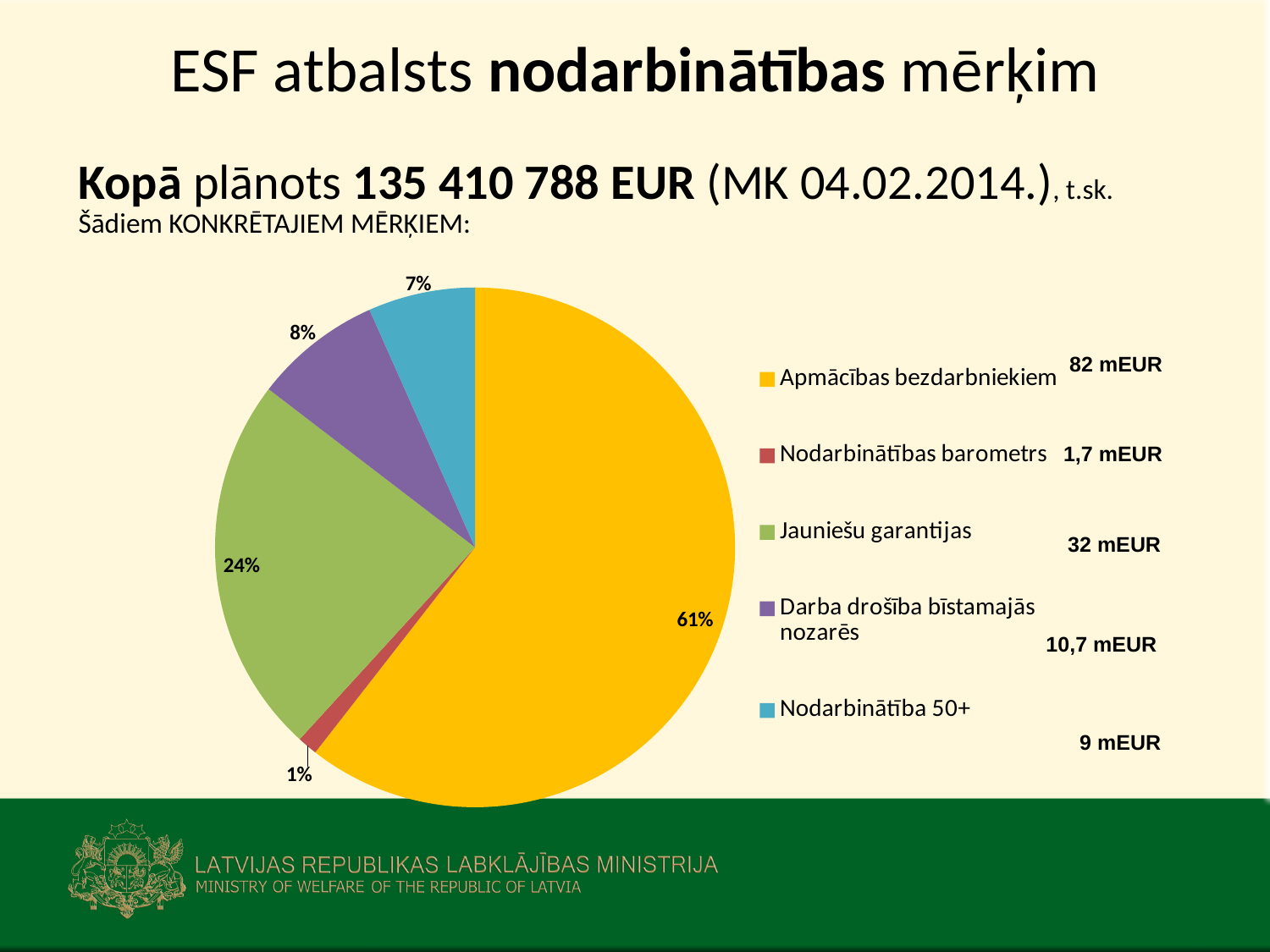
Which slice is larger, Darba drošība bīstamajās nozarēs or Nodarbinātība 50+? Darba drošība bīstamajās nozarēs How many slices does the pie chart have? 5 What share of the pie does Darba drošība bīstamajās nozarēs have? 8% Which category has the largest slice of the pie? Apmācības bezdarbniekiem What share of the pie does Nodarbinātības barometrs have? 1% What share of the pie does Apmācības bezdarbniekiem have? 61% What kind of chart is shown on the slide? pie chart Which category has the smallest slice of the pie? Nodarbinātības barometrs What is the difference in percentage points between the Apmācības bezdarbniekiem slice and the Jauniešu garantijas slice? 37 percentage points What colour is the Jauniešu garantijas slice in the pie chart? green